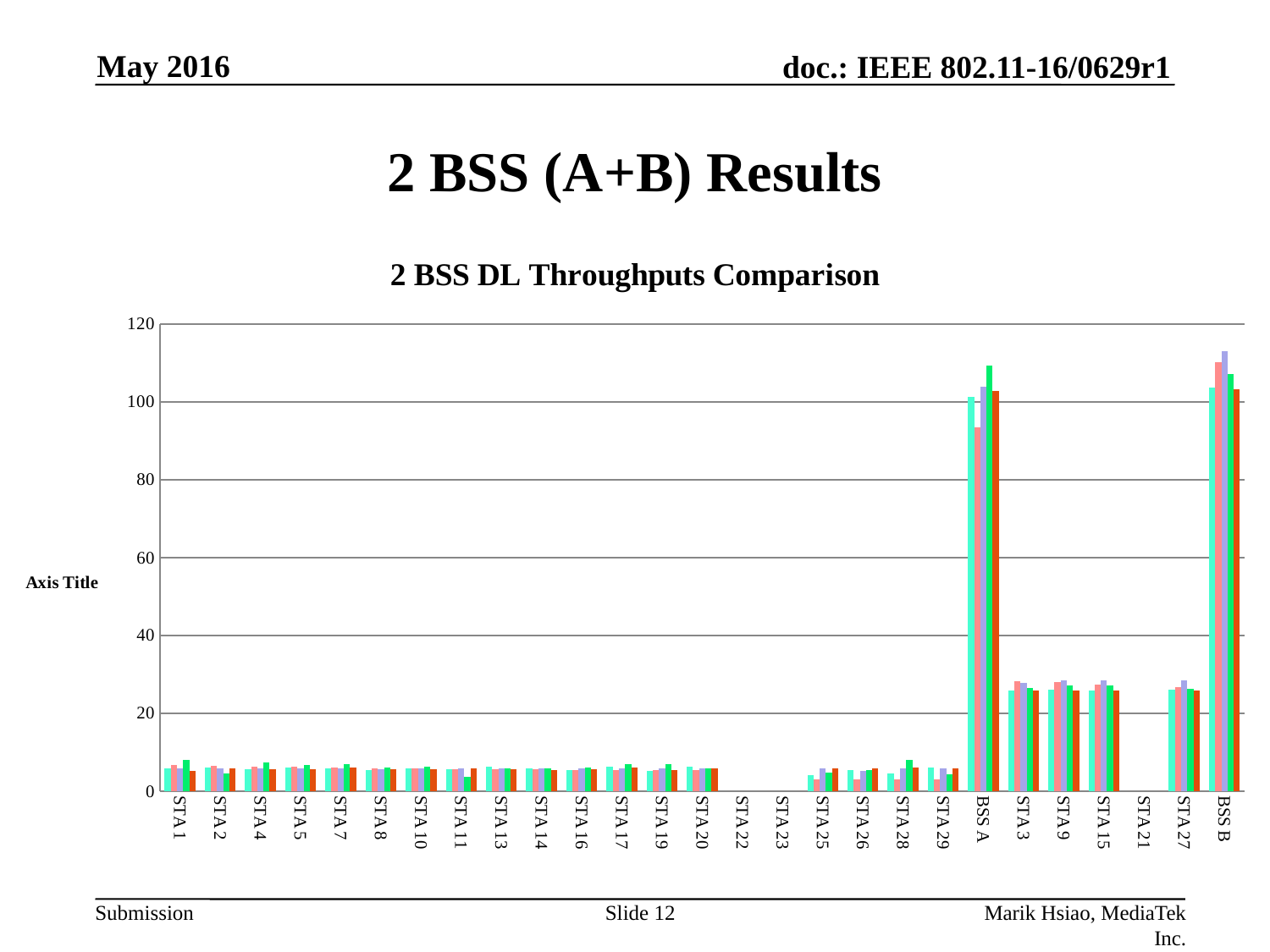
What is the label shown on the vertical axis of the chart? Axis Title Which has a larger value, BSS A or STA 1? BSS A How many categories are shown along the x axis of the chart? 27 Is the value for BSS A greater or less than 80? greater Is the value for STA 1 greater or less than 20? less Which has a larger value, STA 27 or STA 28? STA 27 Is the value for STA 3 greater or less than 20? greater What type of chart is shown on the slide? Bar chart What is the title of the chart? 2 BSS DL Throughputs Comparison What is the highest value shown on the vertical axis of the chart? 120